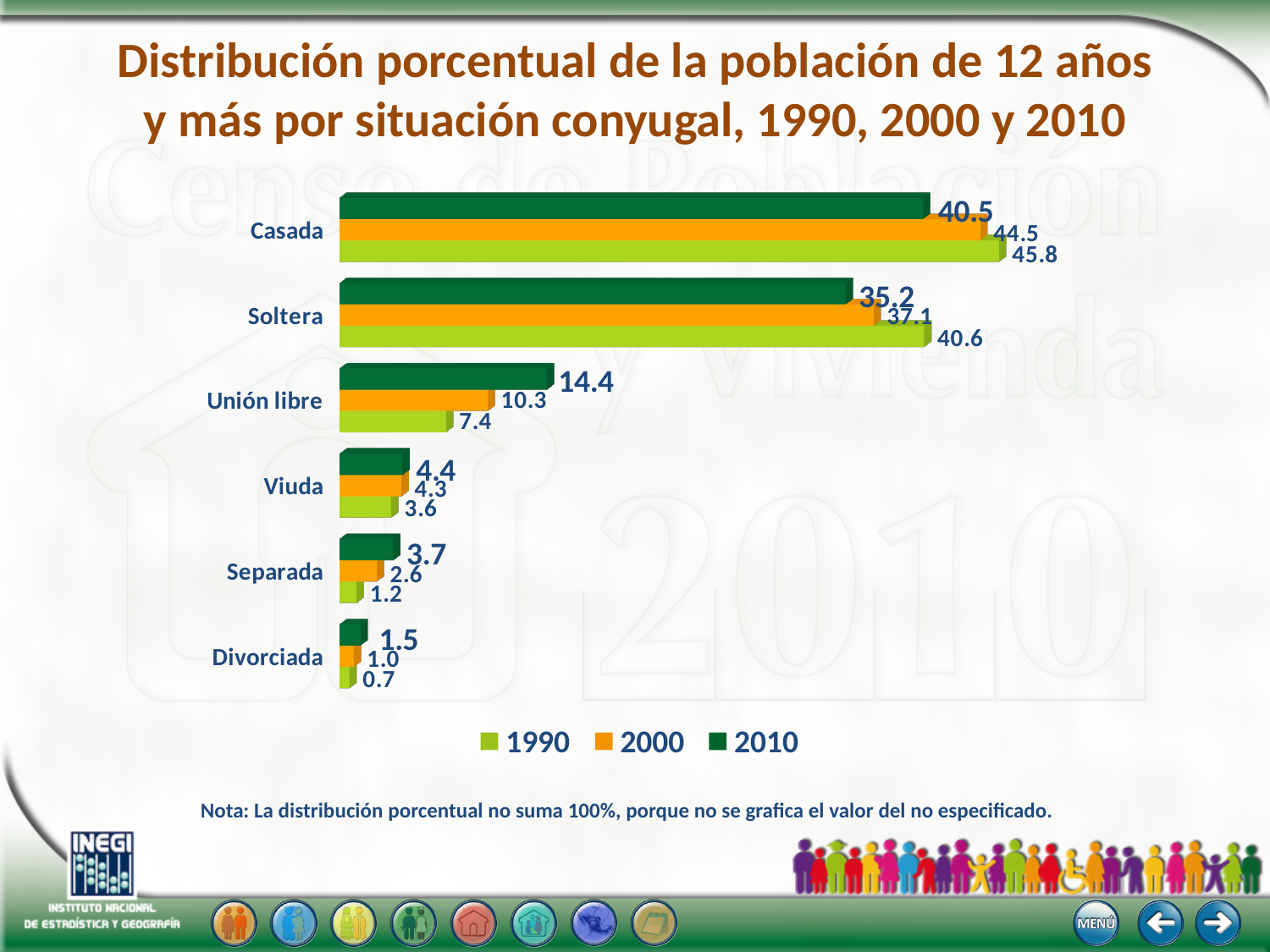
Which is larger: the 2010 value for Unión libre or the 2010 value for Viuda? Unión libre What is the value for Unión libre in 2000? 10.3 What kind of chart is shown on the slide? Bar chart Which category has the lowest value in 2000? Divorciada What is the value for Divorciada in 1990? 0.7 Which category has the highest value in 2010? Casada How many series does the legend list? 3 Which colour represents the 2000 series in the legend? Orange What is the value for Soltera in 1990? 40.6 How many categories are shown on the chart? 6 What is the value for Casada in 2010? 40.5 What is the difference between the 1990 and 2010 values for Casada? 5.3